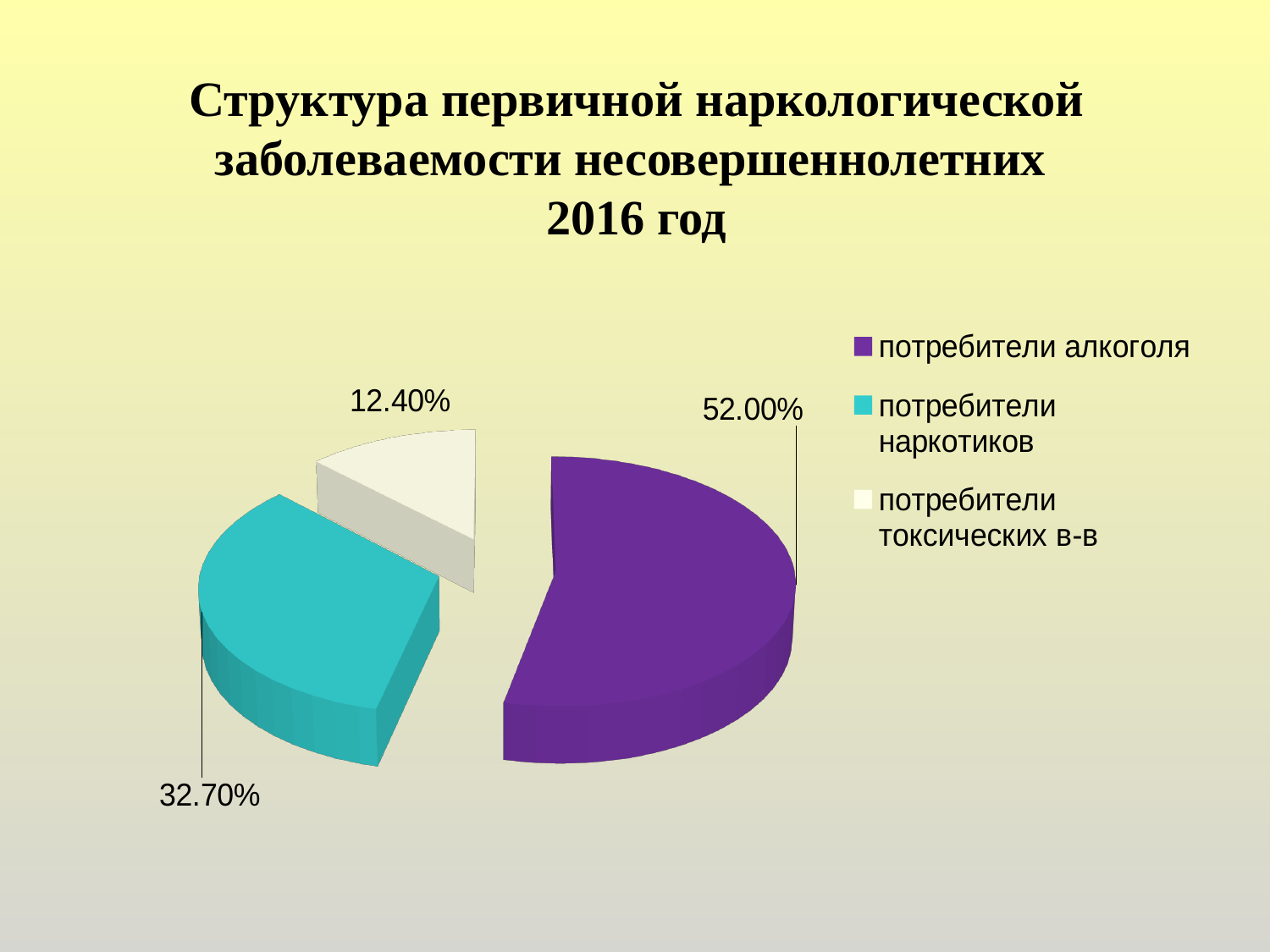
What share of the pie is labelled for потребители токсических в-в? 12.40% Which category has the smallest slice of the pie? потребители токсических в-в What colour is the slice for потребители алкоголя? purple Which is larger: the share for потребители наркотиков or the share for потребители токсических в-в? потребители наркотиков What year is named in the chart title? 2016 What is the difference between the shares for потребители наркотиков and потребители токсических в-в? 20.30% What kind of chart is shown on the slide? pie chart What share of the pie is labelled for потребители наркотиков? 32.70% What is the difference between the shares for потребители алкоголя and потребители наркотиков? 19.30% Which category has the largest slice of the pie? потребители алкоголя What share of the pie is labelled for потребители алкоголя? 52.00% How many categories does the pie chart show? 3